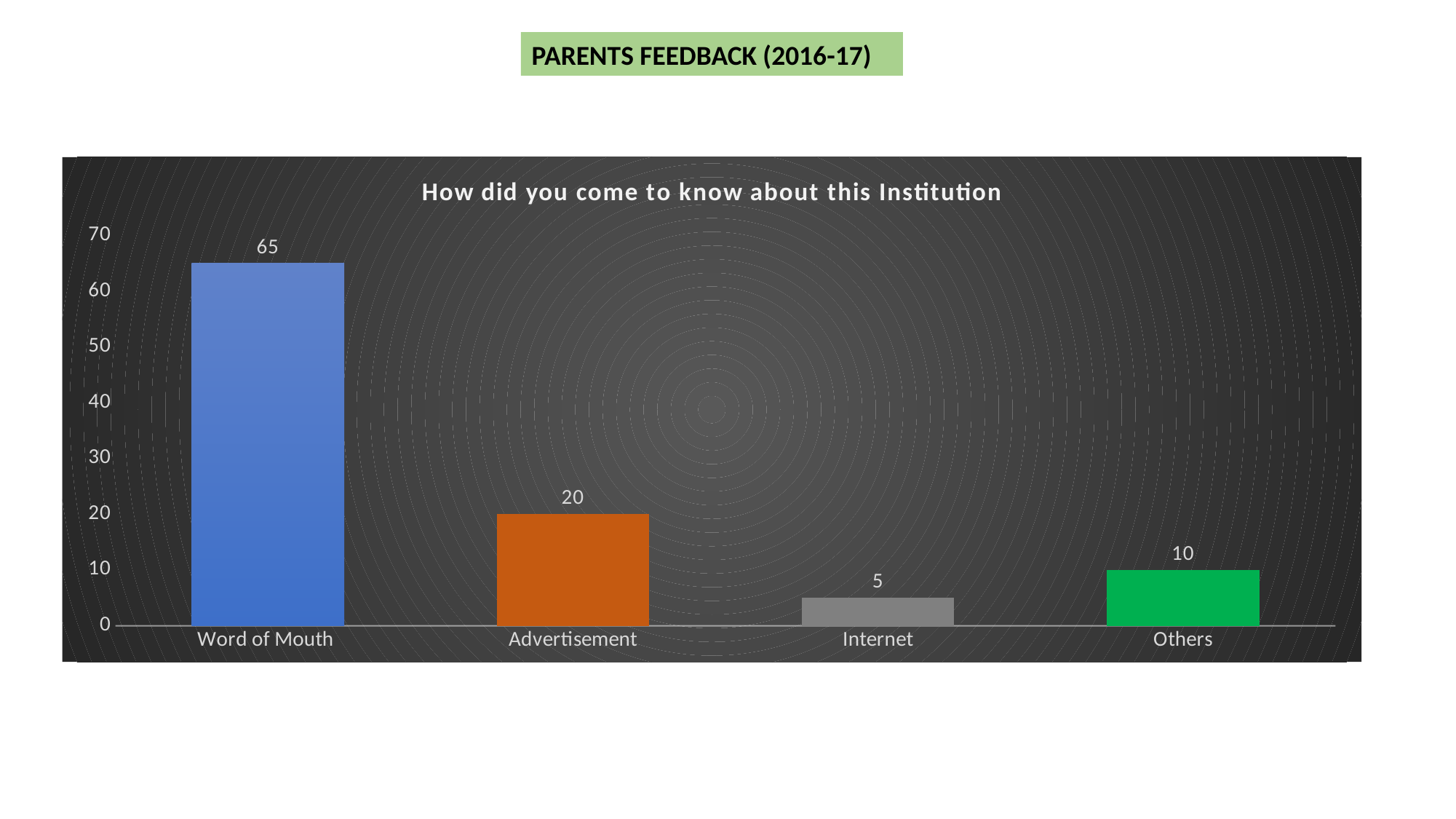
What is the value for Word of Mouth? 65 Which category has the highest value? Word of Mouth What kind of chart is shown on the slide? Bar chart What is the value for Advertisement? 20 What is the difference between the values for Word of Mouth and Advertisement? 45 Is the value for Word of Mouth greater or less than 60? greater Which is larger, the value for Advertisement or the value for Others? Advertisement How many categories are shown on the x axis? 4 Which category has the lowest value? Internet What is the title of the chart? How did you come to know about this Institution What is the value for Internet? 5 What is the value for Others? 10